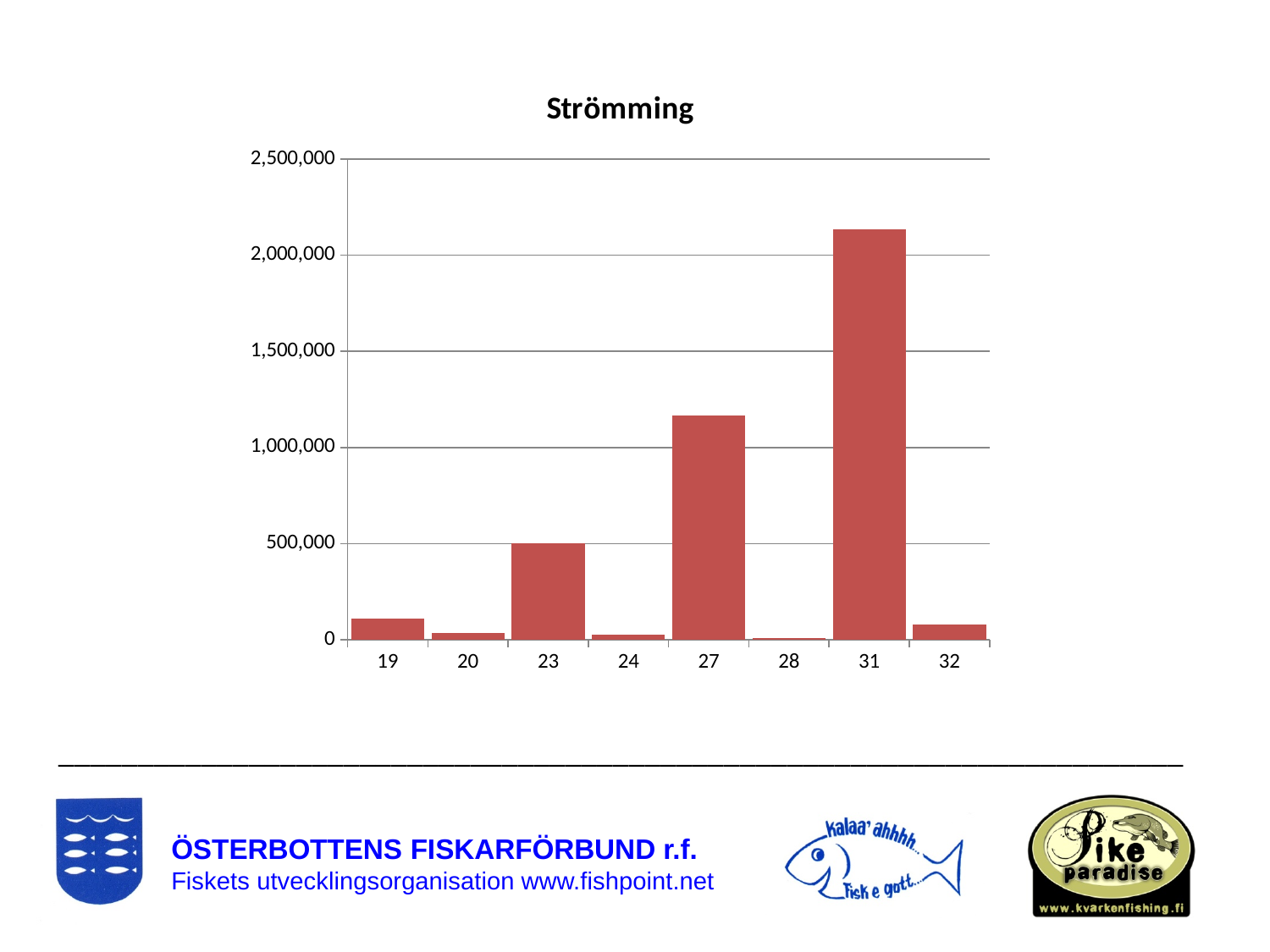
Is the value for 27 greater or less than 1,000,000? greater Which has the larger value, 27 or 23? 27 Is the value for 31 greater or less than 2,000,000? greater Is the value for 19 greater or less than 500,000? less How many categories are shown on the x axis of the chart? 8 Which category has the highest value in the chart? 31 What is the title of the chart? Strömming Which has the larger value, 31 or 27? 31 Which category has the lowest value in the chart? 28 What colour are the bars in the chart? red What kind of chart is shown on the slide? bar chart